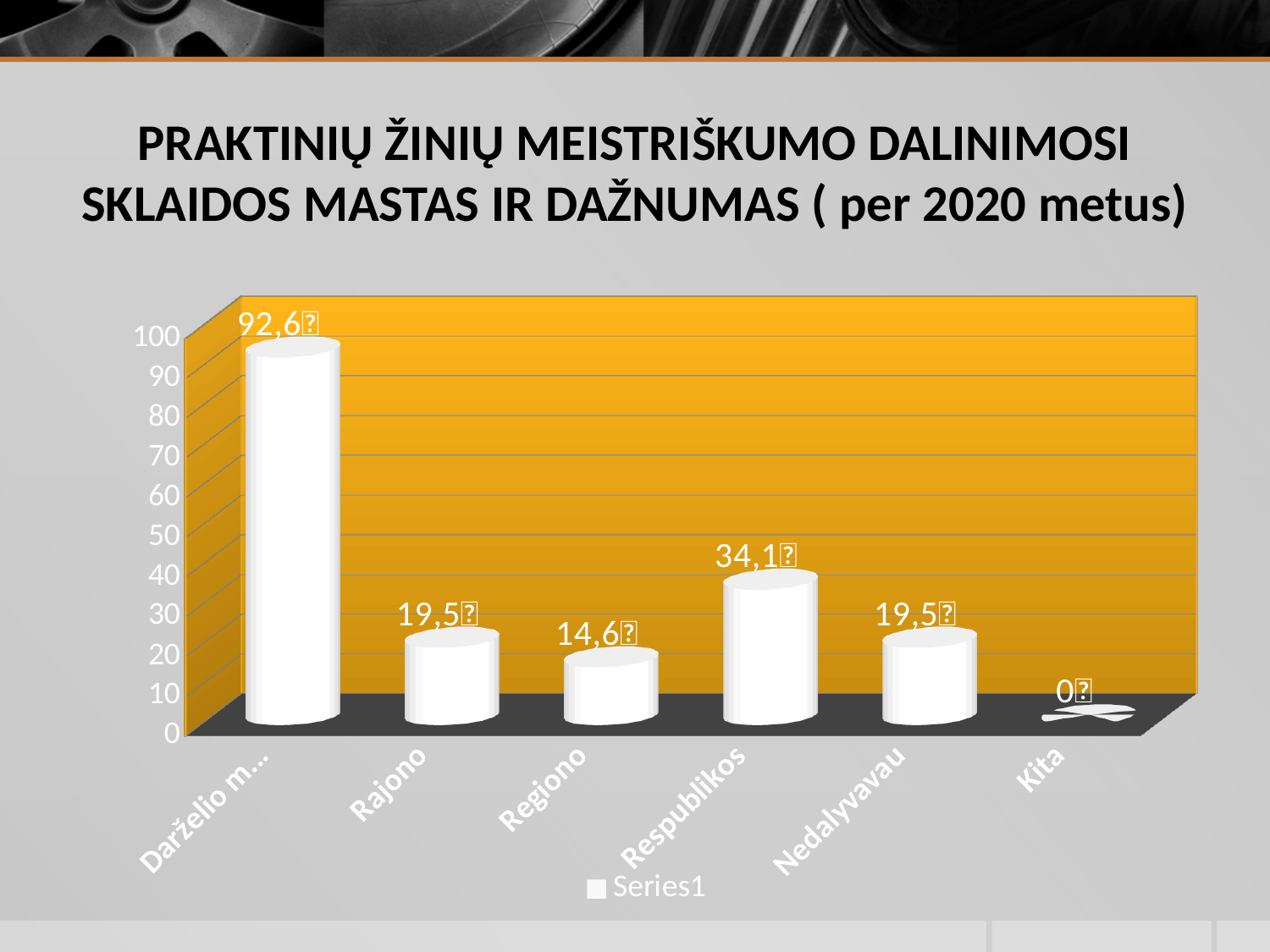
How many series does the legend list? 1 How many categories are shown on the x axis? 6 What is the value for Kita? 0 Which is larger, the value for Respublikos or the value for Nedalyvavau? Respublikos Which category has the highest value? Darželio m... Is the value for Respublikos greater or less than 30? greater Which category has the lowest value? Kita What is the difference between the values for Respublikos and Regiono? 19,5 What is the value for Rajono? 19,5 What is the value for Regiono? 14,6 What is the value for Respublikos? 34,1 What kind of chart is shown on the slide? bar chart